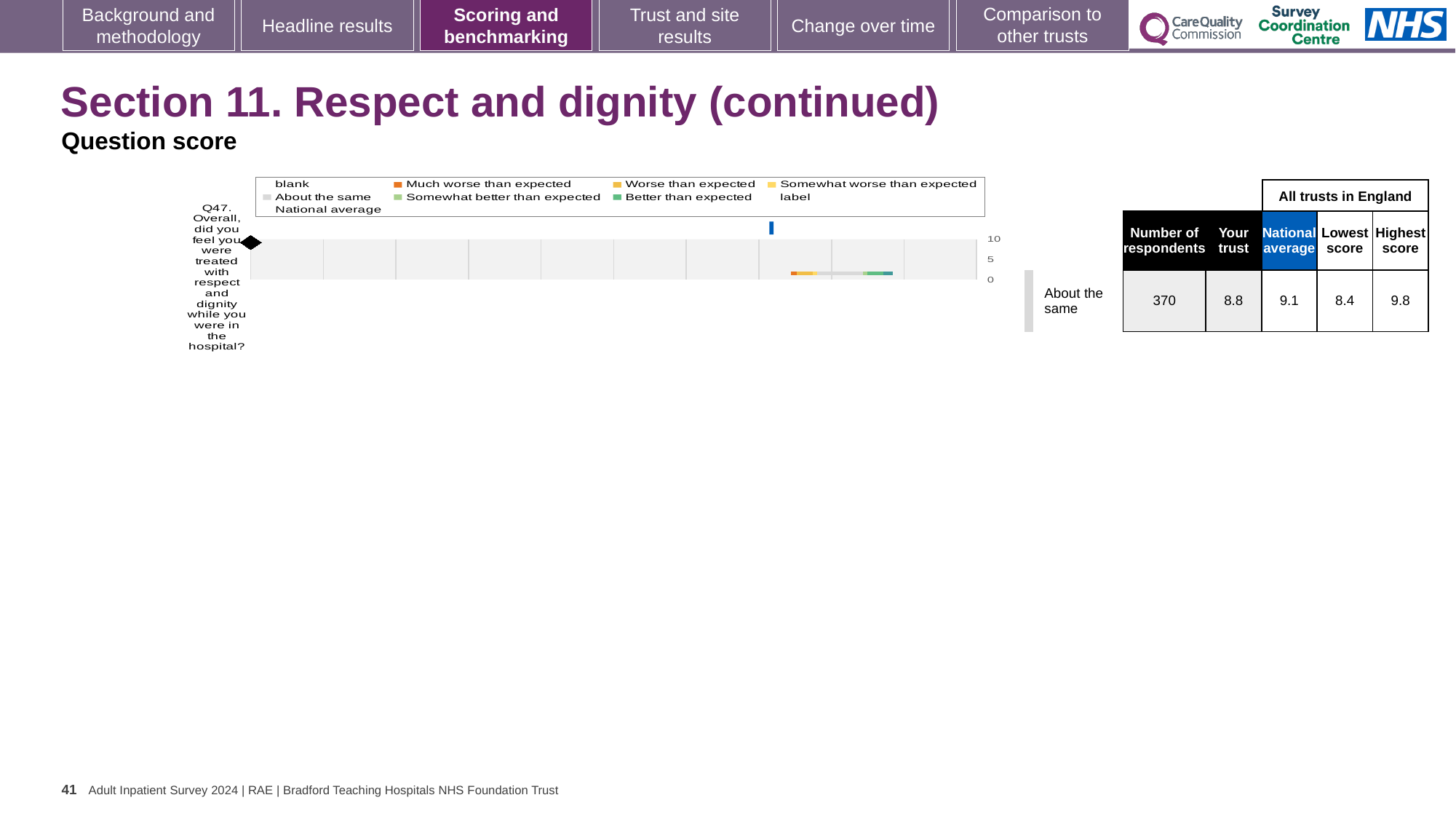
How many entries does the chart legend list? 9 For Q47, which is larger: the 'Your trust' score or the national average? National average In the table beside the chart, what is the highest score among all trusts in England for Q47? 9.8 What kind of chart is used to show the Q47 score? bar chart What is the highest tick value shown on the chart's score axis? 10 How many questions are plotted on the chart? 1 In the table beside the chart, what is the 'Your trust' score for Q47? 8.8 In the table beside the chart, what is the lowest score among all trusts in England for Q47? 8.4 Which benchmark category is Q47 placed in, according to the label beside the chart? About the same In the table beside the chart, how many respondents answered Q47? 370 For Q47, what is the difference between the highest score and the lowest score among all trusts in England? 1.4 In the table beside the chart, what is the national average score for Q47? 9.1